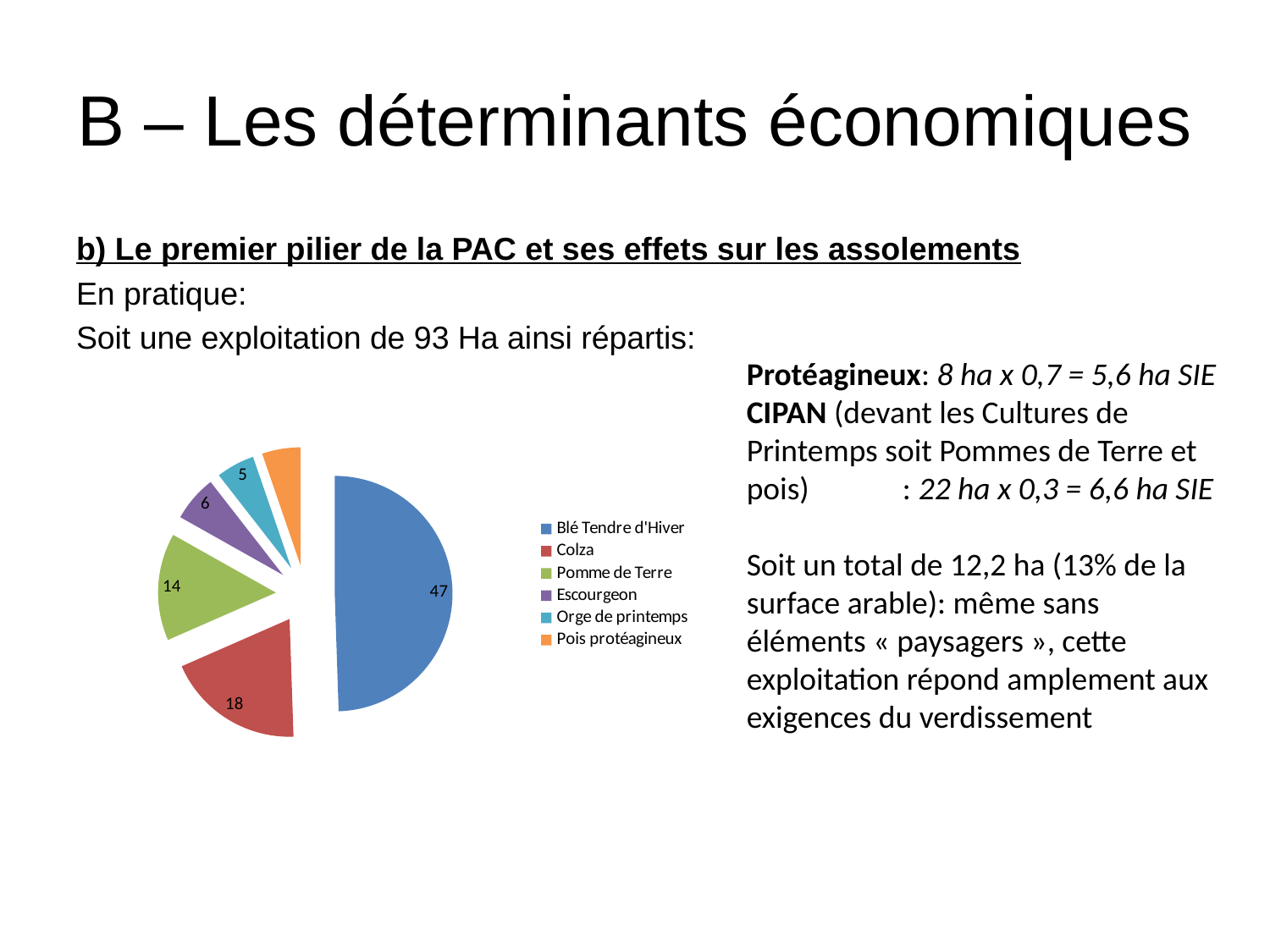
What is the difference between the values for Colza and Pomme de Terre? 4 What type of chart is shown on the slide? Pie chart What is the difference between the values for Blé Tendre d'Hiver and Colza? 29 What value is shown for Escourgeon in the pie chart? 6 What value is shown for Blé Tendre d'Hiver in the pie chart? 47 What value is shown for Colza in the pie chart? 18 What value is shown for Orge de printemps in the pie chart? 5 What value is shown for Pomme de Terre in the pie chart? 14 Which category has the largest slice in the pie chart? Blé Tendre d'Hiver Which is larger in the pie chart, Colza or Pomme de Terre? Colza How many categories does the pie chart show? 6 What colour is the Blé Tendre d'Hiver slice in the pie chart? Blue